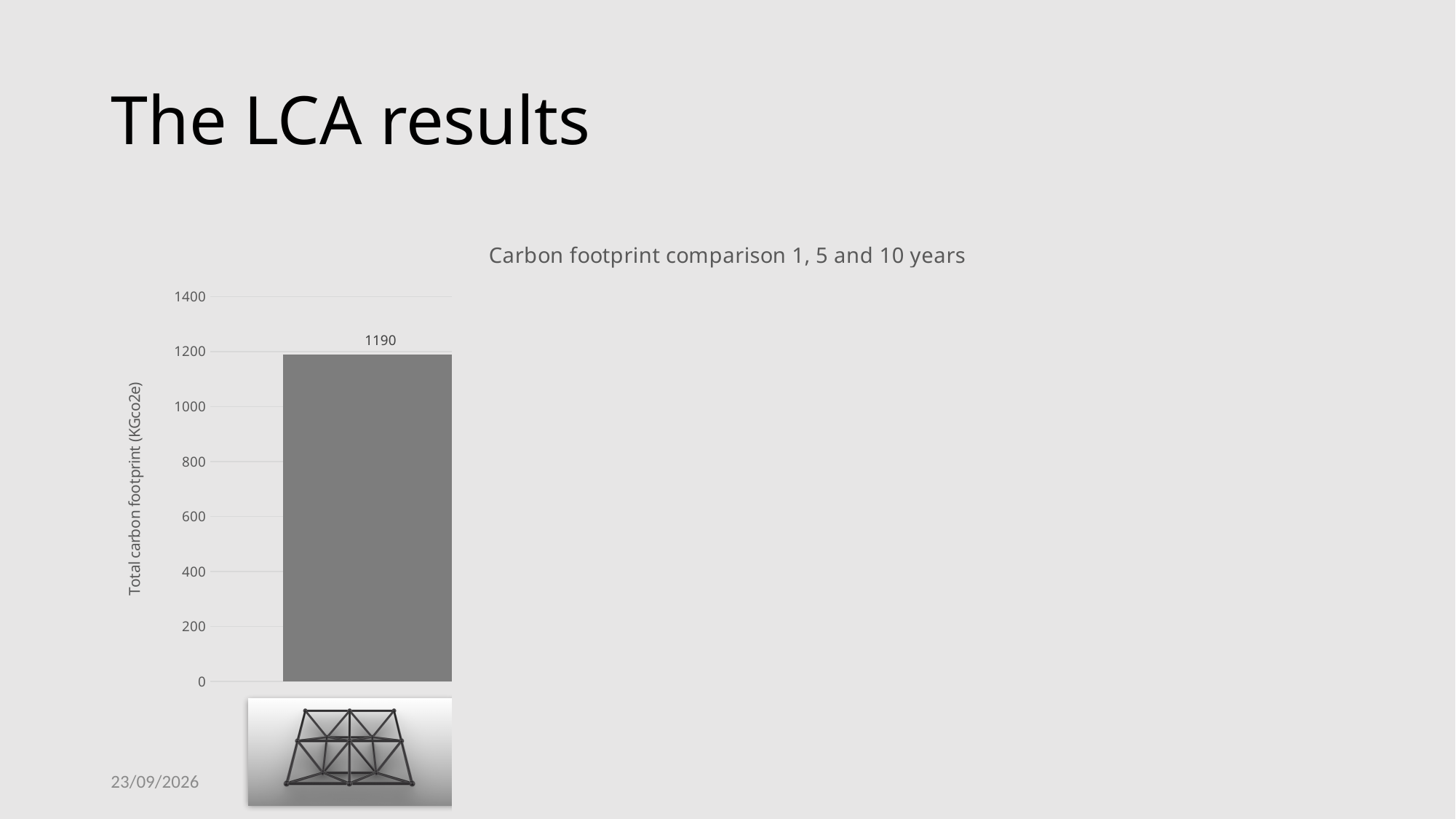
What is the highest tick value shown on the vertical axis of the chart? 1400 What value is printed on the bar in the chart? 1190 How many bars are plotted in the chart? 1 What kind of chart is shown on the slide? bar chart What is the label on the vertical axis of the chart? Total carbon footprint (KGco2e) Is the value of the bar in the chart greater or less than 1200? less What is the title of the chart? Carbon footprint comparison 1, 5 and 10 years Is the value of the bar in the chart greater or less than 1000? greater